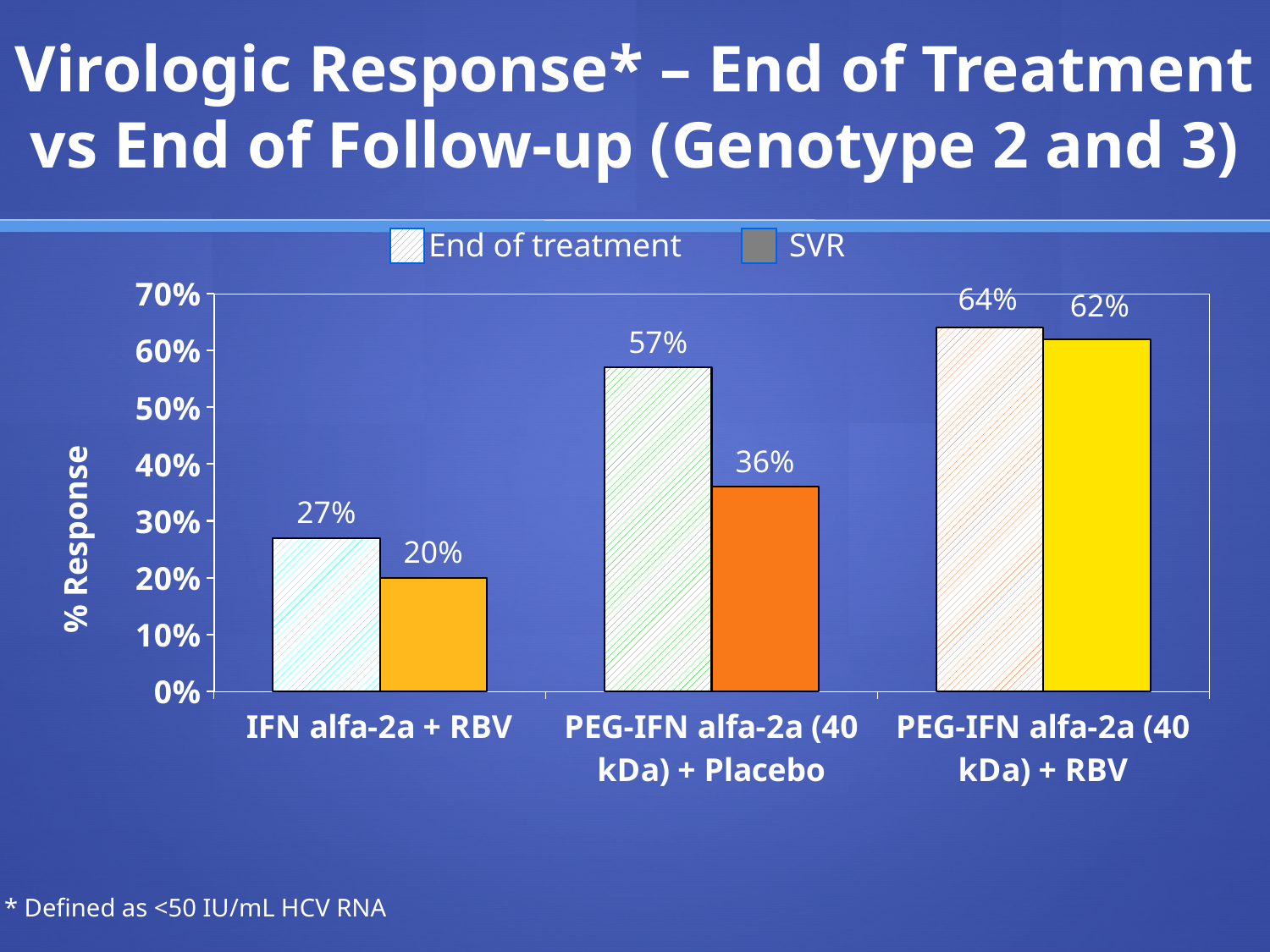
What is the difference between the SVR values for PEG-IFN alfa-2a (40 kDa) + RBV and IFN alfa-2a + RBV? 42% Which is larger: the SVR value for PEG-IFN alfa-2a (40 kDa) + Placebo or the End of treatment value for IFN alfa-2a + RBV? SVR value for PEG-IFN alfa-2a (40 kDa) + Placebo What is the difference between the End of treatment and SVR values for PEG-IFN alfa-2a (40 kDa) + Placebo? 21% Which treatment group has the highest End of treatment response? PEG-IFN alfa-2a (40 kDa) + RBV How many treatment groups are shown on the x axis? 3 What is the SVR value for PEG-IFN alfa-2a (40 kDa) + RBV? 62% What is the SVR value for PEG-IFN alfa-2a (40 kDa) + Placebo? 36% What kind of chart is shown on the slide? bar chart What is the End of treatment value for IFN alfa-2a + RBV? 27% Is the End of treatment value for PEG-IFN alfa-2a (40 kDa) + Placebo greater or less than 50%? greater How many series does the legend list? 2 Which treatment group has the lowest SVR value? IFN alfa-2a + RBV